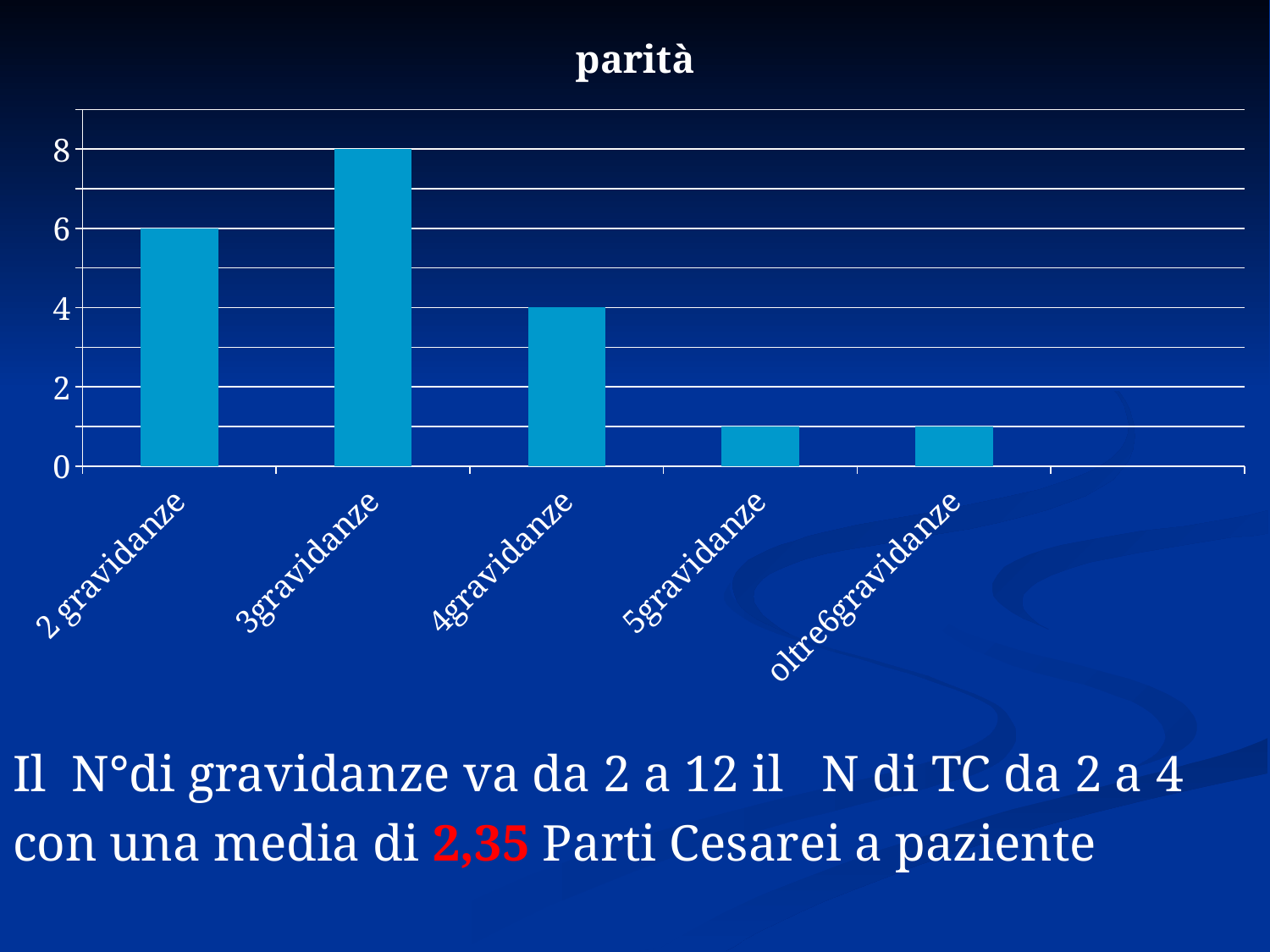
Which category has the highest value? 3gravidanze What type of chart is shown on the slide? bar chart Is the value for 5gravidanze greater or less than 2? less What is the difference between the values for 3gravidanze and 2 gravidanze? 2 What is the difference between the values for 3gravidanze and 4gravidanze? 4 Which is larger, the value for 2 gravidanze or the value for 4gravidanze? 2 gravidanze What is the value for 2 gravidanze? 6 How many categories are shown on the x axis of the chart? 5 Is the value for oltre6gravidanze greater or less than 2? less What is the title of the chart? parità What is the value for 3gravidanze? 8 What is the value for 4gravidanze? 4